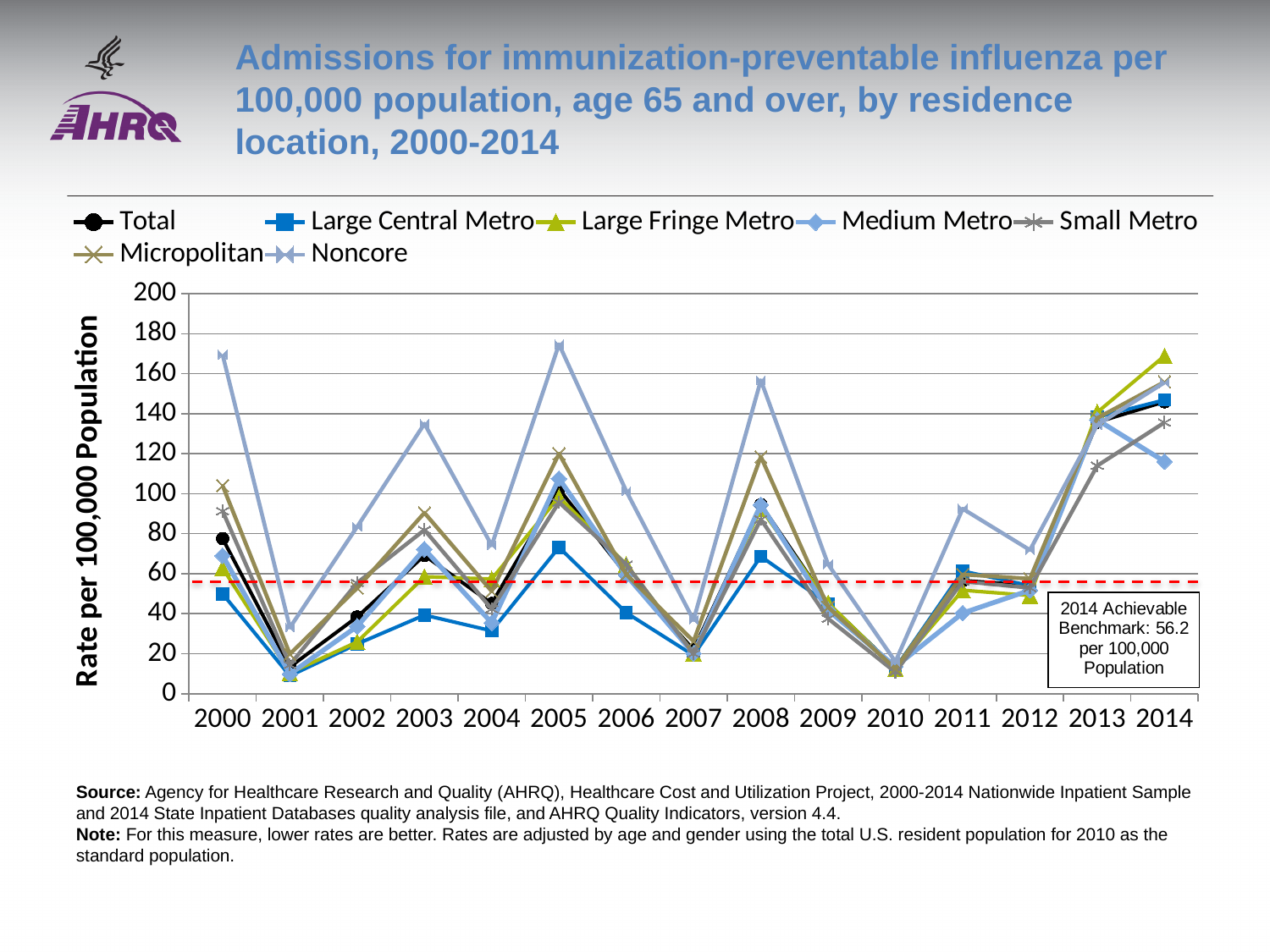
How many series does the legend list? 7 Is the value for Total in 2010 greater or less than 20? less Which residence location has the lowest rate in 2014? Medium Metro Which residence location has the highest rate in 2014? Large Fringe Metro What is the 2014 Achievable Benchmark shown on the chart? 56.2 per 100,000 Population Is the value for Large Central Metro in 2000 greater or less than 60? less For Noncore, is the rate larger in 2008 or in 2009? 2008 Is the value for Noncore in 2000 greater or less than 140? greater Does the Total rate rise or fall from 2012 to 2014? Rise Which residence location has the highest rate in 2005? Noncore How many years are plotted along the x axis? 15 What kind of chart is shown on the slide? Line chart